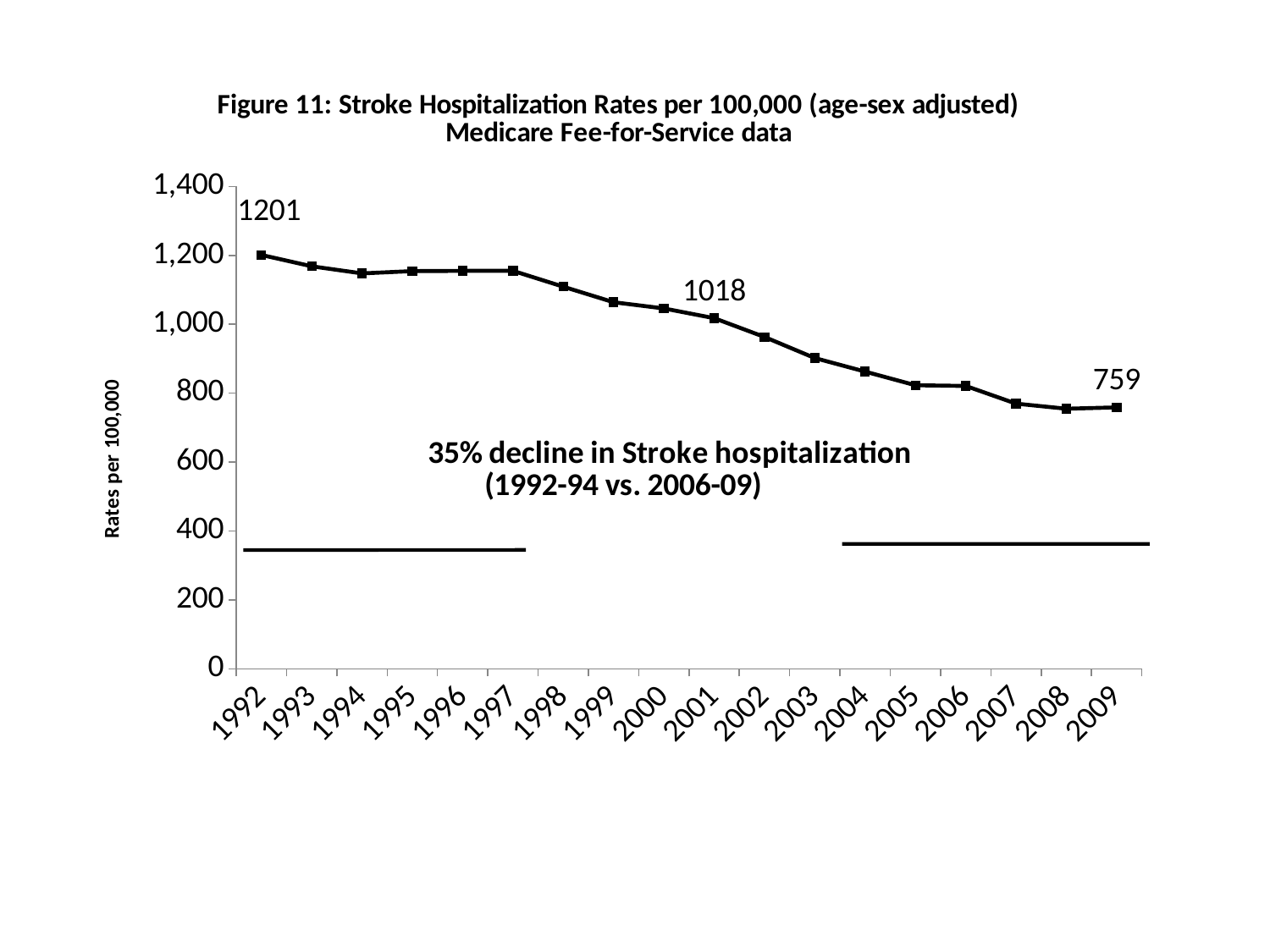
What is the stroke hospitalization rate per 100,000 shown for 1992? 1201 How many years are plotted on the x axis? 18 Is the value for 2003 greater or less than 1,000? less Do the stroke hospitalization rates rise or fall from 1992 to 2009? fall Which year has the highest stroke hospitalization rate? 1992 What is the stroke hospitalization rate per 100,000 shown for 2001? 1018 Which year has the larger stroke hospitalization rate, 1992 or 2009? 1992 What is the difference between the 1992 rate and the 2009 rate? 442 What kind of chart is shown on the slide? line chart What is the difference between the 1992 rate and the 2001 rate? 183 Is the value for 1998 greater or less than 1,000? greater What is the stroke hospitalization rate per 100,000 shown for 2009? 759